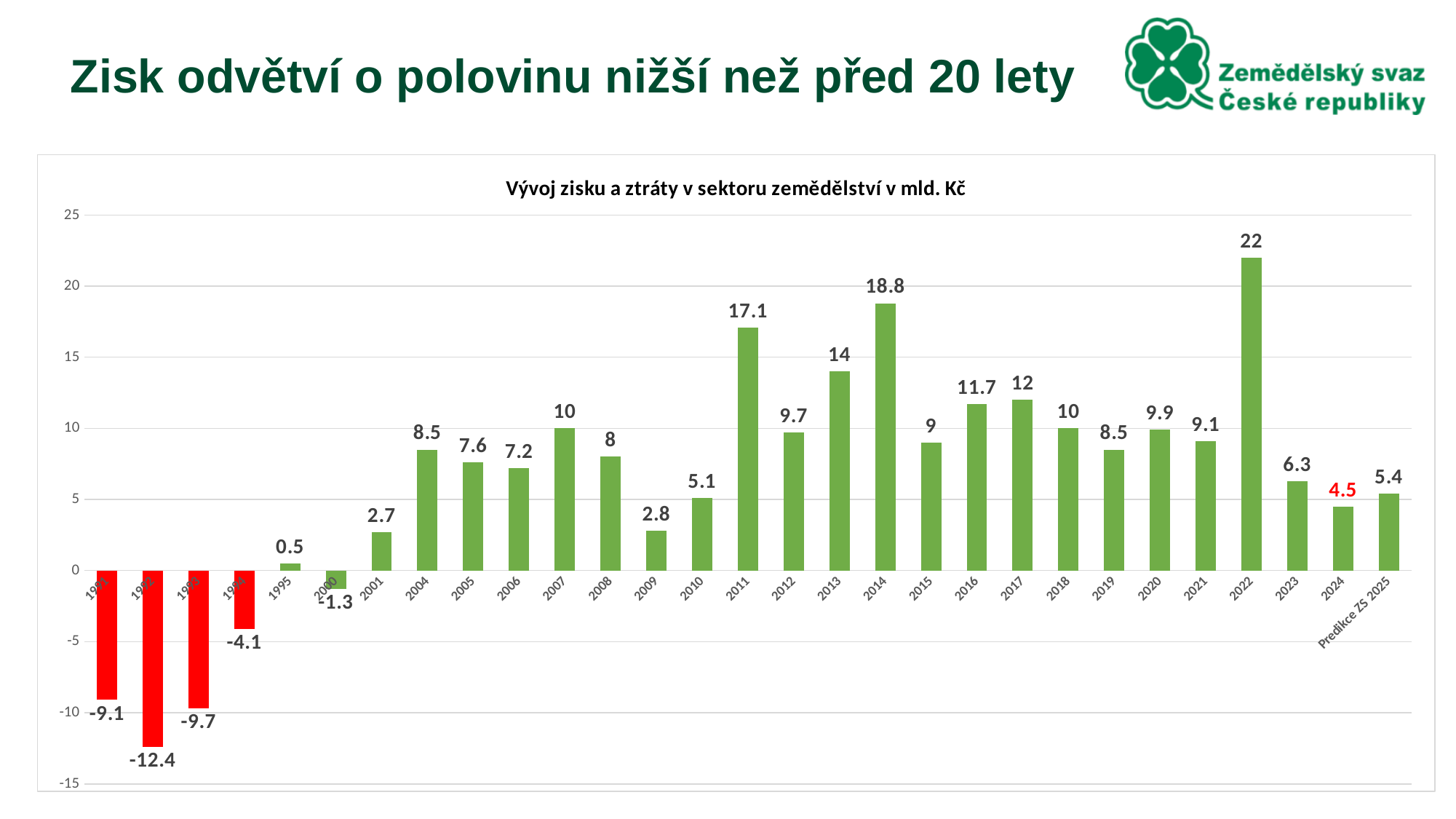
Which is larger, the value for 2011 or the value for 2013? 2011 What is the title of the chart? Vývoj zisku a ztráty v sektoru zemědělství v mld. Kč What kind of chart is shown on the slide? bar chart What is the difference between the values for 2022 and 2023? 15.7 What is the value for 2022? 22 What is the value for 2014? 18.8 Which year has the highest value? 2022 Which year has the lowest value? 1992 What is the value for 2024? 4.5 What is the value for Predikce ZS 2025? 5.4 Is the value for 2017 greater or less than 10? greater How many bars are plotted in the chart? 29